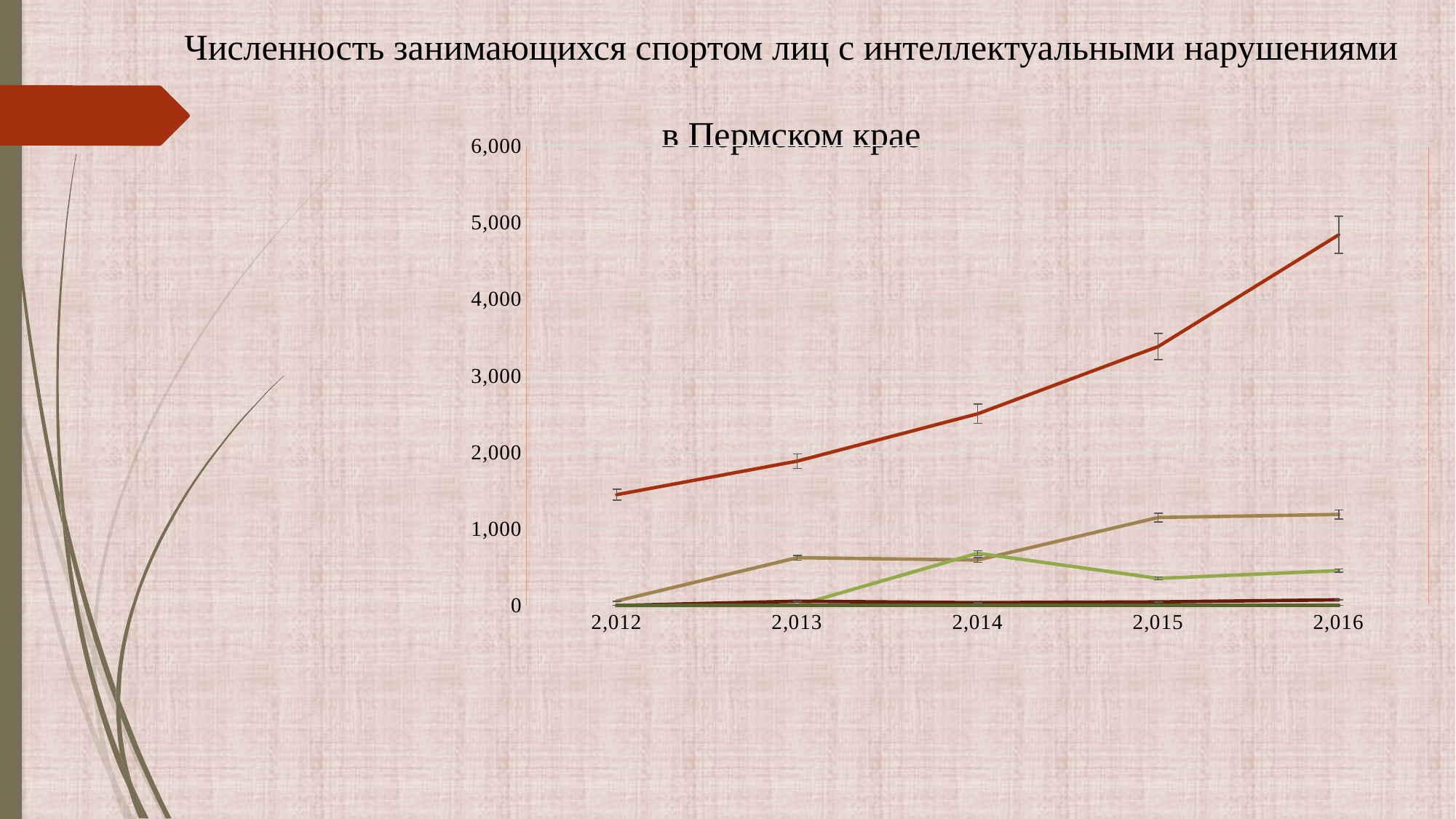
Is the value of the red (top) line in 2,016 greater or less than 4,000? greater What is the first year shown on the x axis of the chart? 2,012 Is the value of the tan (brown) line in 2,016 greater or less than 1,000? greater In 2,016, which line has the larger value, the red line or the tan (brown) line? the red line Does the red (top) line rise or fall from 2,012 to 2,016? rises Is the value of the red (top) line in 2,012 greater or less than 2,000? less How many years are plotted along the x axis of the chart? 5 In which year does the red (top) line reach its highest value? 2,016 What is the highest value shown on the y axis of the chart? 6,000 What kind of chart is shown on the slide? line chart